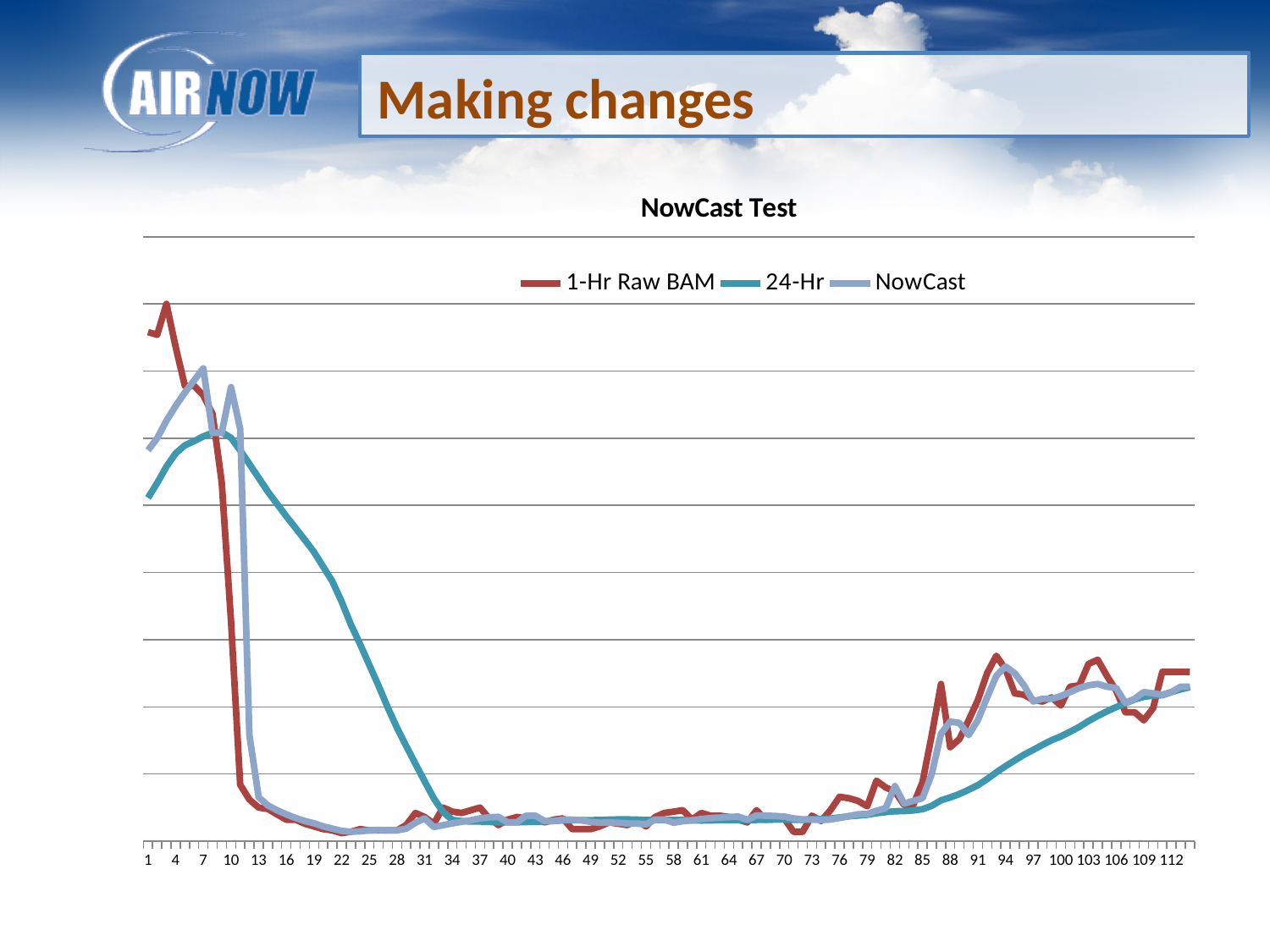
What kind of chart is shown on the slide? line chart Does the 1-Hr Raw BAM series rise or fall between x = 4 and x = 13? fall At x = 100, which series has the higher value, 24-Hr or NowCast? NowCast Which series reaches the highest point anywhere on the chart? 1-Hr Raw BAM Which series is drawn in red in the NowCast Test chart? 1-Hr Raw BAM How many series does the legend of the NowCast Test chart list? 3 What is the title of the chart? NowCast Test Which series is the smoothest (least jagged) line on the chart? 24-Hr Does the 24-Hr series rise or fall between x = 13 and x = 34? fall At x = 1, which series has the higher value, 1-Hr Raw BAM or 24-Hr? 1-Hr Raw BAM Does the 24-Hr series rise or fall between x = 85 and x = 112? rise